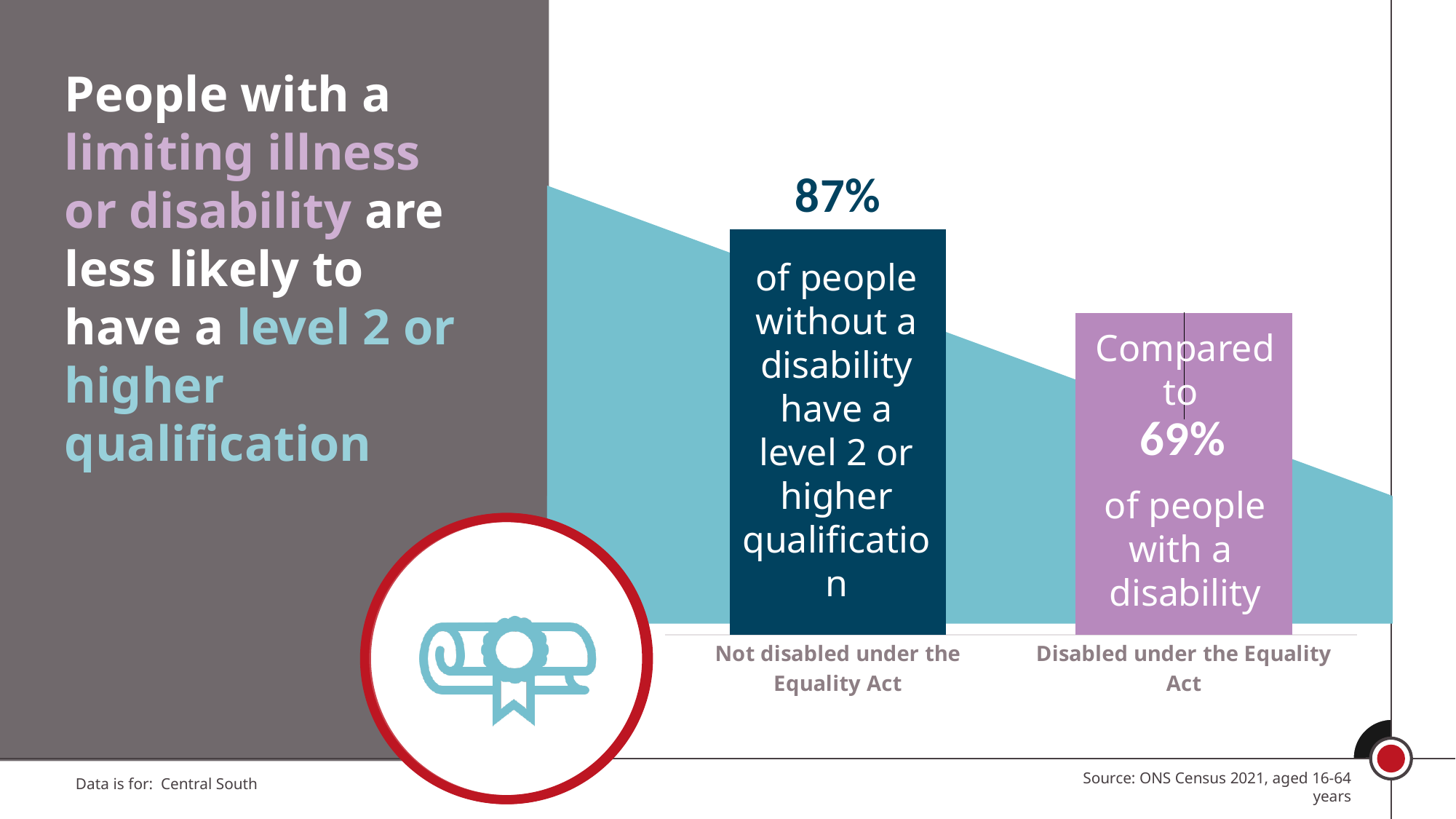
What colour is the bar for people disabled under the Equality Act? purple What percentage of people not disabled under the Equality Act have a level 2 or higher qualification? 87% What is the source of the data shown in the chart? ONS Census 2021, aged 16-64 years What kind of chart is shown on the slide? bar chart Which category has the lower value? Disabled under the Equality Act How many categories are shown in the chart? 2 Which category has the higher value? Not disabled under the Equality Act What percentage of people disabled under the Equality Act have a level 2 or higher qualification? 69% What is the difference in percentage points between the two bars? 18 Is the value for people not disabled under the Equality Act larger or smaller than the value for people disabled under the Equality Act? larger